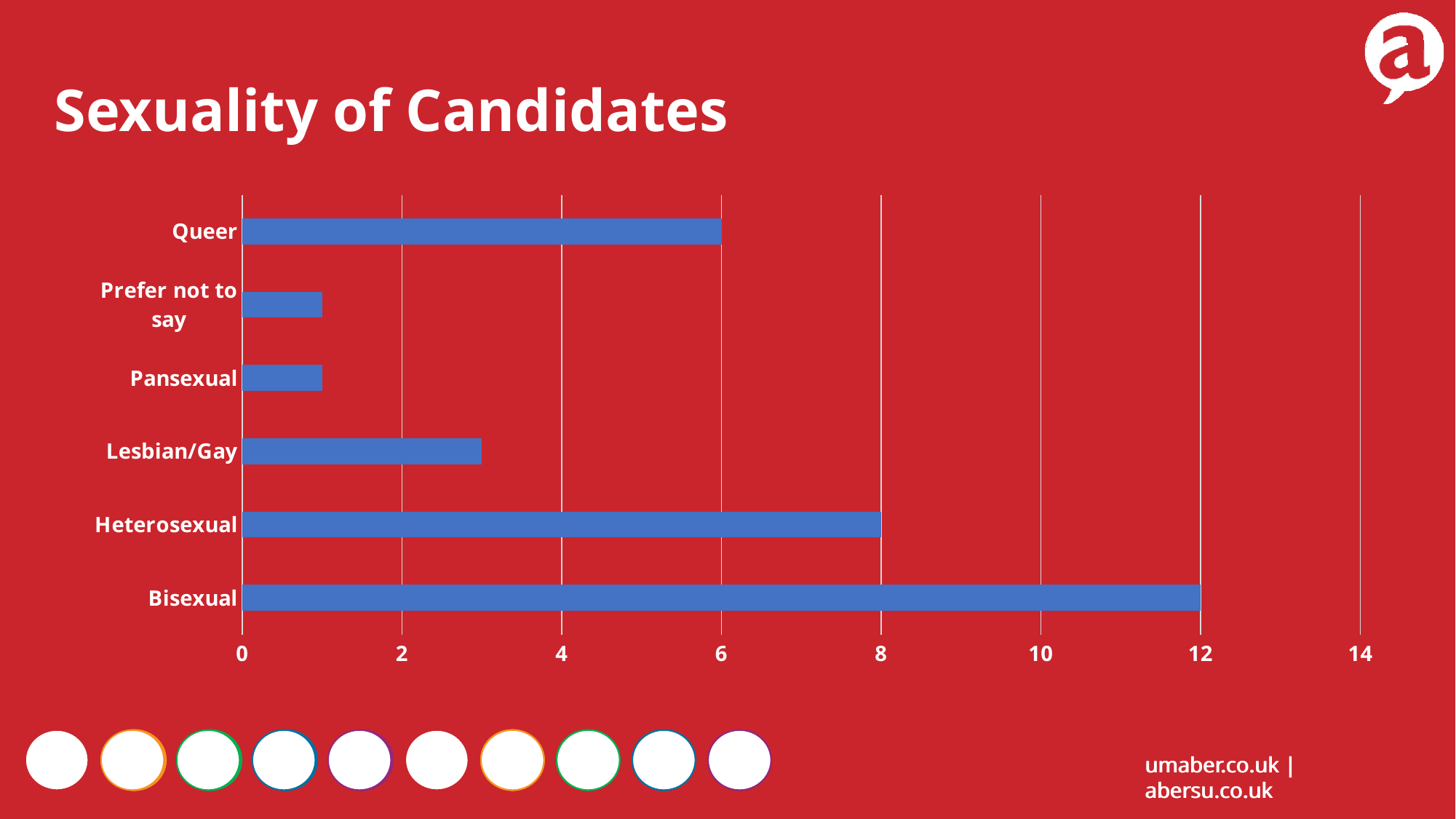
What is the difference between the values for Heterosexual and Queer? 2 How many categories are shown in the chart? 6 What is the value for Heterosexual? 8 What is the difference between the values for Bisexual and Heterosexual? 4 What is the value for Bisexual? 12 Is the value for Lesbian/Gay greater or less than 4? less What kind of chart is shown on the slide? bar chart What is the value for Queer? 6 Is the value for Pansexual greater or less than 2? less Which category has the highest value? Bisexual Which is larger, the value for Queer or the value for Lesbian/Gay? Queer What is the title of the chart? Sexuality of Candidates